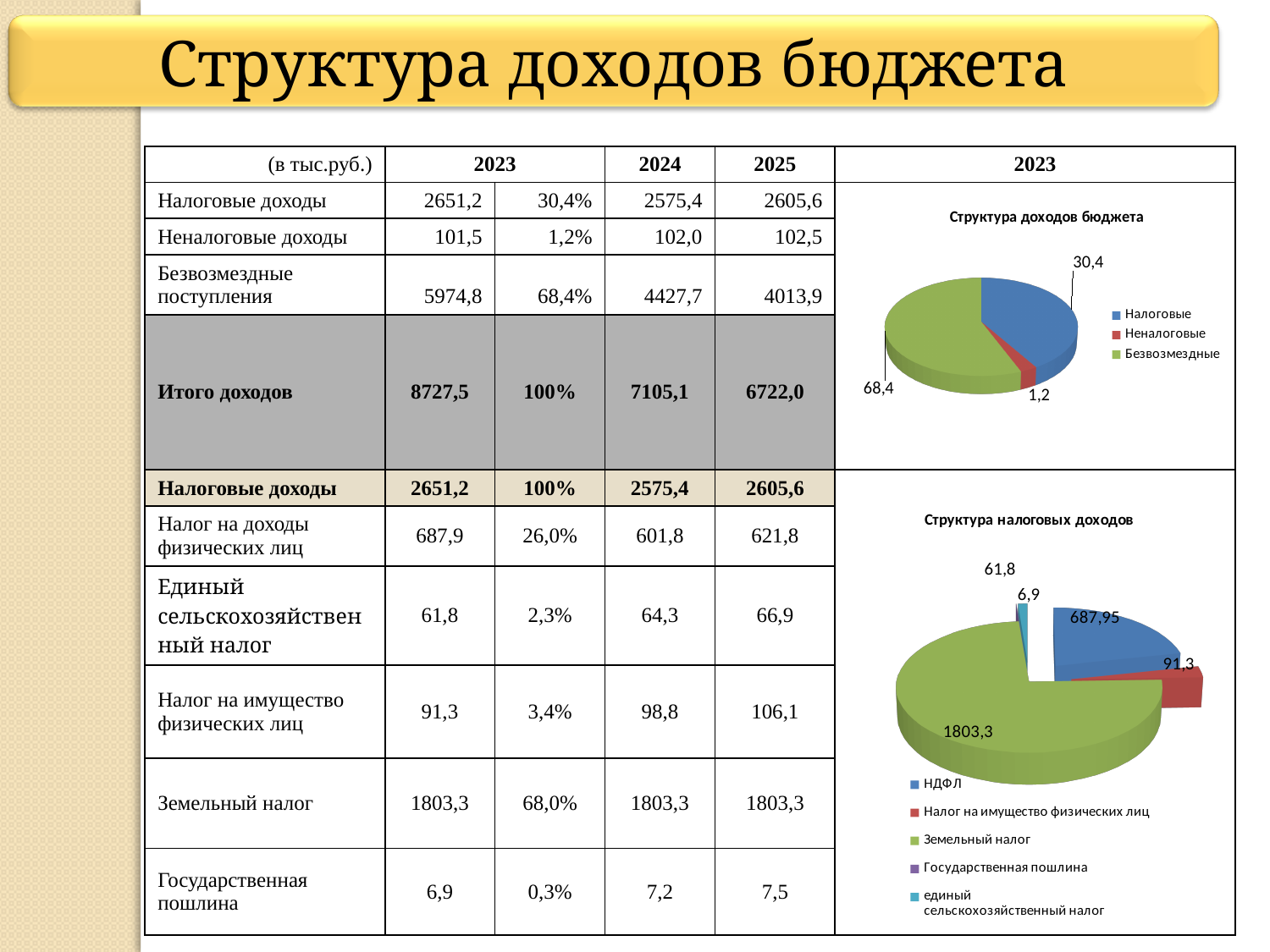
In the chart titled "Структура налоговых доходов", which category has the largest slice? Земельный налог What kind of chart is the chart titled "Структура налоговых доходов"? Pie chart In the chart titled "Структура налоговых доходов", what value is shown for Государственная пошлина? 6,9 In the chart titled "Структура доходов бюджета", which category has the smallest slice? Неналоговые How many categories does the legend of the chart titled "Структура налоговых доходов" list? 5 In the chart titled "Структура налоговых доходов", what value is shown for НДФЛ? 687,95 In the chart titled "Структура налоговых доходов", what value is shown for Земельный налог? 1803,3 In the chart titled "Структура налоговых доходов", which is larger: the value for Налог на имущество физических лиц or the value for единый сельскохозяйственный налог? Налог на имущество физических лиц In the chart titled "Структура доходов бюджета", what value is shown for the Безвозмездные slice? 68,4 In the chart titled "Структура доходов бюджета", which category has the largest slice? Безвозмездные How many entries does the legend of the chart titled "Структура доходов бюджета" list? 3 In the chart titled "Структура доходов бюджета", what value is shown for the Налоговые slice? 30,4